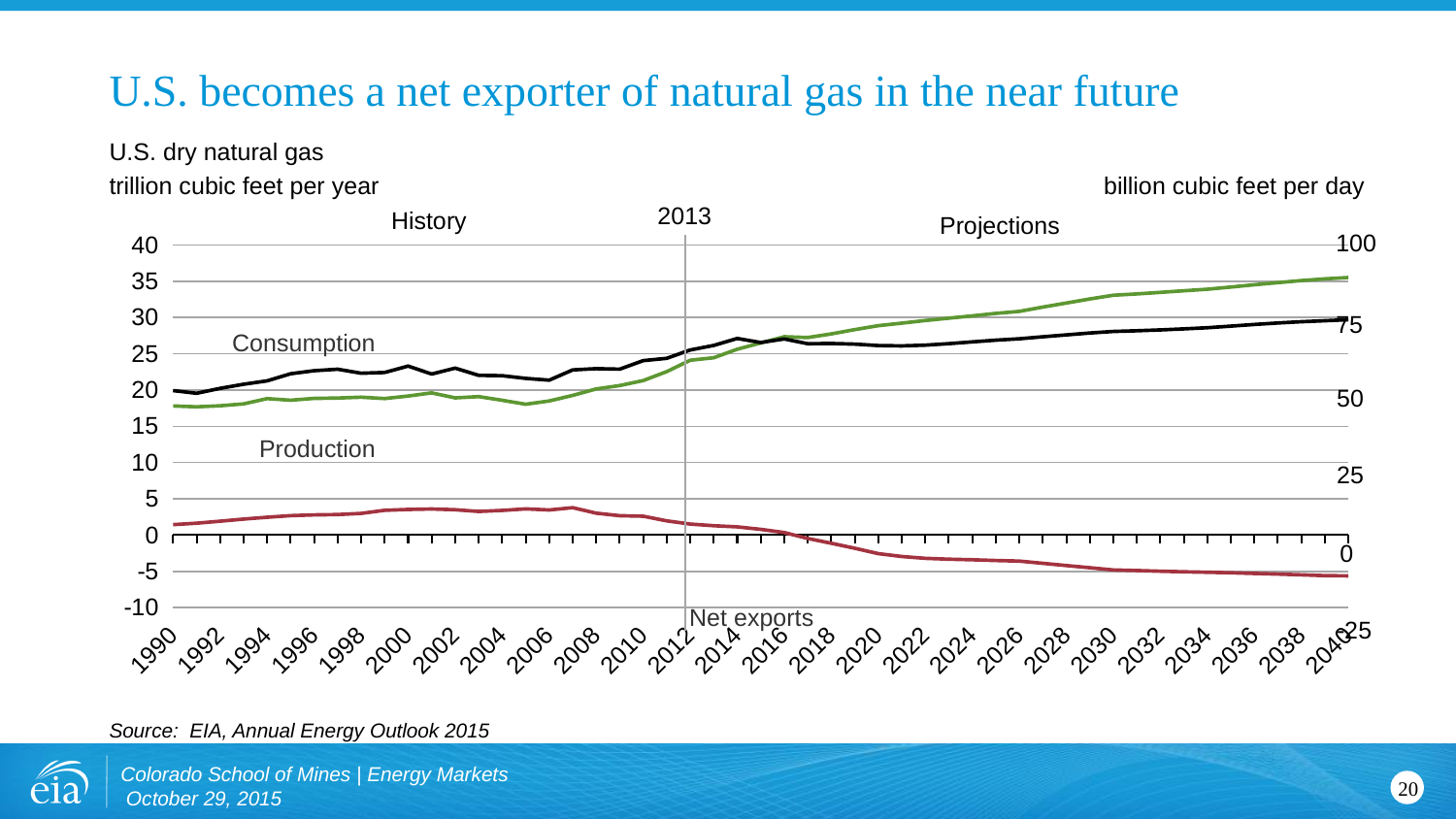
Do Net exports rise or fall from 2013 to 2040? fall Is the value for Production in 1990 greater or less than 20? less What unit is shown on the left axis of the chart? trillion cubic feet per year Is the value for Production in 2040 greater or less than 30? greater Is the value for Net exports in 2040 greater or less than 0? less How many series are plotted on the chart? 3 What kind of chart is shown on the slide? line chart Which series is higher in 1990, Production or Consumption? Consumption What year does the vertical line separating History from Projections mark? 2013 Which series is higher in 2040, Production or Consumption? Production Does Production rise or fall over the projection period from 2013 to 2040? rise